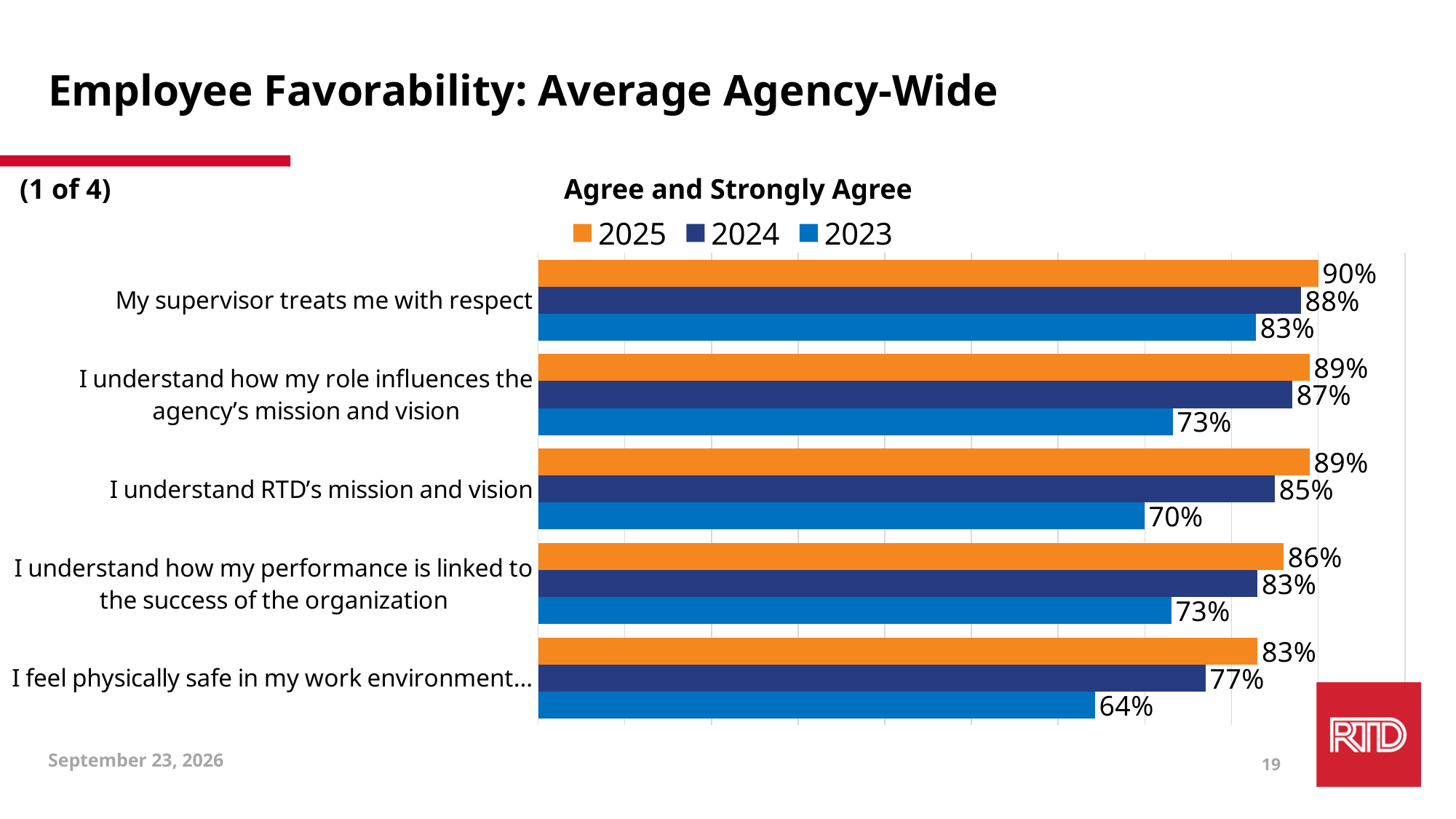
What is the 2024 value for "I understand RTD's mission and vision"? 85% Which statement has the highest 2025 value? My supervisor treats me with respect What kind of chart is shown on the slide? Bar chart Which is larger: the 2024 value for "My supervisor treats me with respect" or the 2024 value for "I feel physically safe in my work environment..."? My supervisor treats me with respect What is the difference between the 2025 and 2023 values for "I understand RTD's mission and vision"? 19% How many statements (categories) are shown in the chart? 5 For "I understand how my performance is linked to the success of the organization", do the values rise or fall from 2023 to 2025? Rise What is the 2025 value for "My supervisor treats me with respect"? 90% Which statement has the lowest 2023 value? I feel physically safe in my work environment... How many series does the legend list? 3 What is the 2023 value for "I feel physically safe in my work environment..."? 64% What is the title of the chart? Agree and Strongly Agree